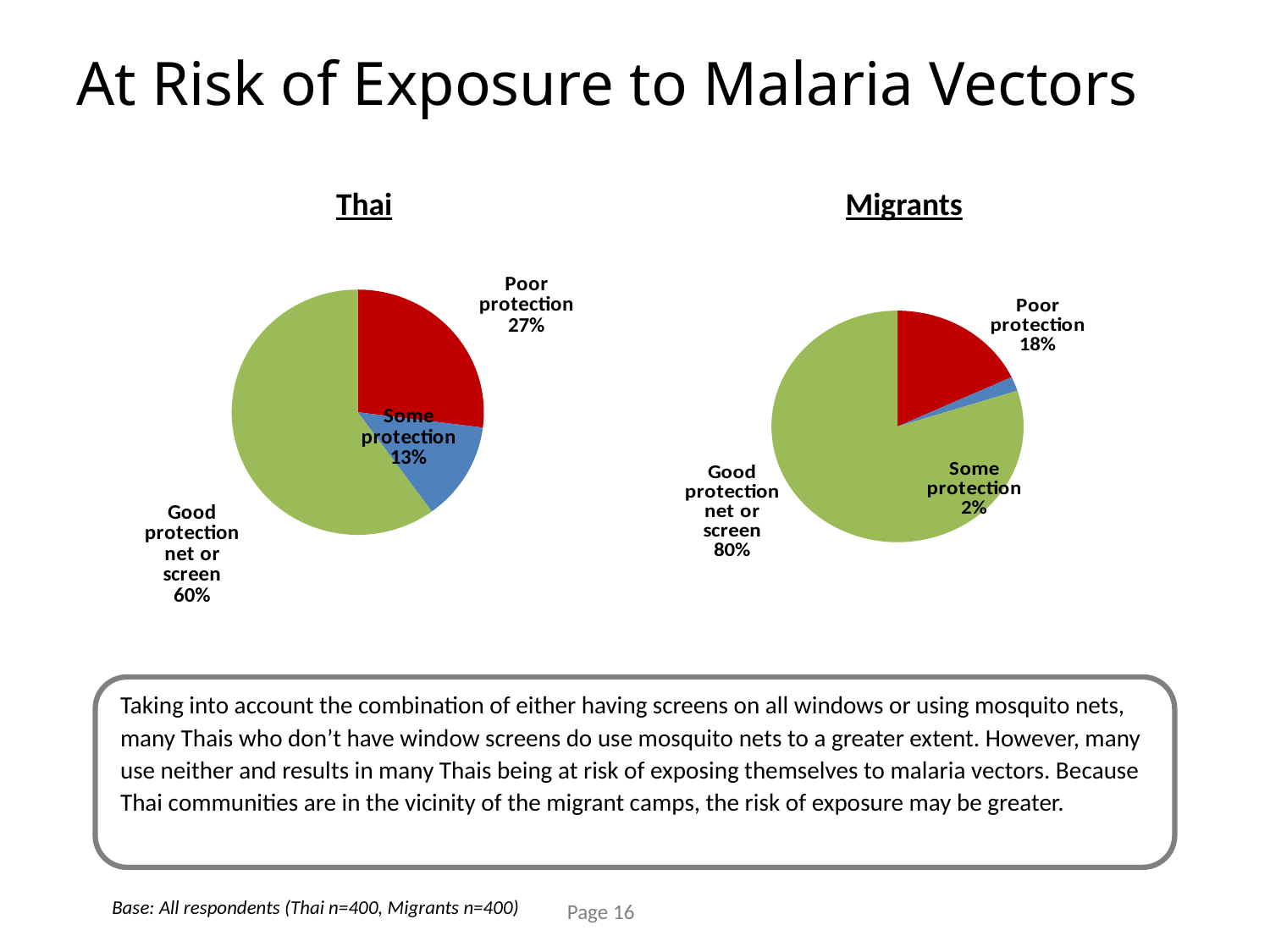
What is the difference between the 'Poor protection' share in the Thai chart and in the Migrants chart? 9 percentage points In the Thai pie chart, what share is labelled 'Some protection'? 13% In the Migrants pie chart, which category has the smallest slice? Some protection In the Migrants pie chart, what share is labelled 'Good protection net or screen'? 80% What type of chart is used for the Migrants data? Pie chart In the Migrants pie chart, what share is labelled 'Poor protection'? 18% In the Thai pie chart, what share is labelled 'Poor protection'? 27% In the Thai pie chart, which category has the largest slice? Good protection net or screen How many slices does the Thai pie chart have? 3 What colour is the 'Poor protection' slice in both pie charts? Red In the Thai pie chart, what is the combined share of 'Poor protection' and 'Some protection'? 40% Which chart shows a larger 'Good protection net or screen' share, Thai or Migrants? Migrants